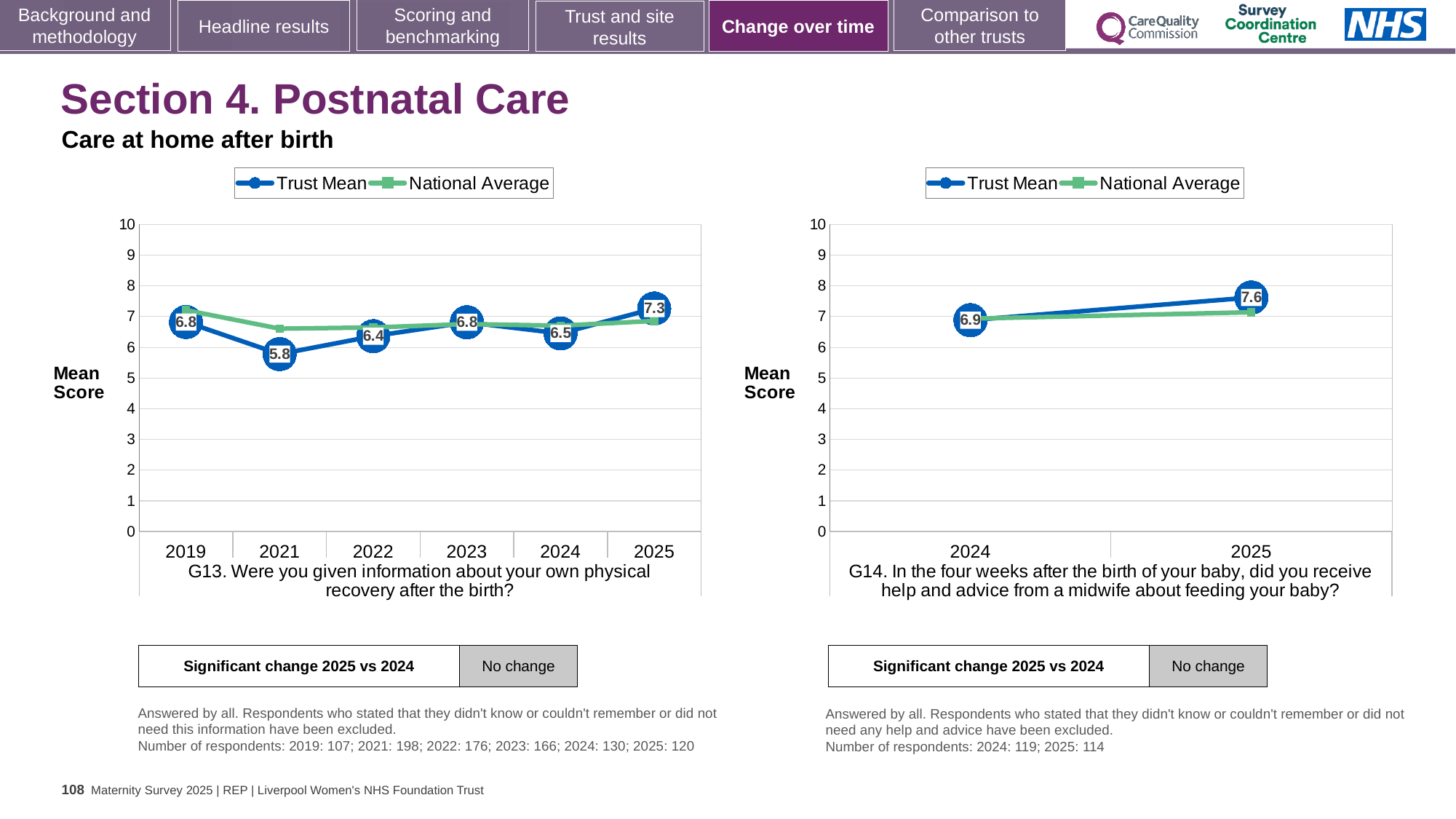
In the G13 chart, what is the Trust Mean for 2021? 5.8 In the G13 chart, what is the Trust Mean for 2025? 7.3 In the G14 chart, what is the Trust Mean for 2024? 6.9 In the G14 chart, what is the difference between the Trust Mean for 2025 and 2024? 0.7 How many series does the legend of the G14 chart list? 2 How many years are plotted on the x axis of the G13 chart? 6 What kind of chart is the G14 chart? line chart In the G14 chart, is the National Average for 2025 greater or less than 8? less In the G13 chart, which year has the lowest Trust Mean? 2021 In the G13 chart, what is the difference between the Trust Mean for 2025 and the Trust Mean for 2021? 1.5 In the G13 chart, which year has the highest Trust Mean? 2025 In the G13 chart, is the Trust Mean for 2024 or 2023 larger? 2023